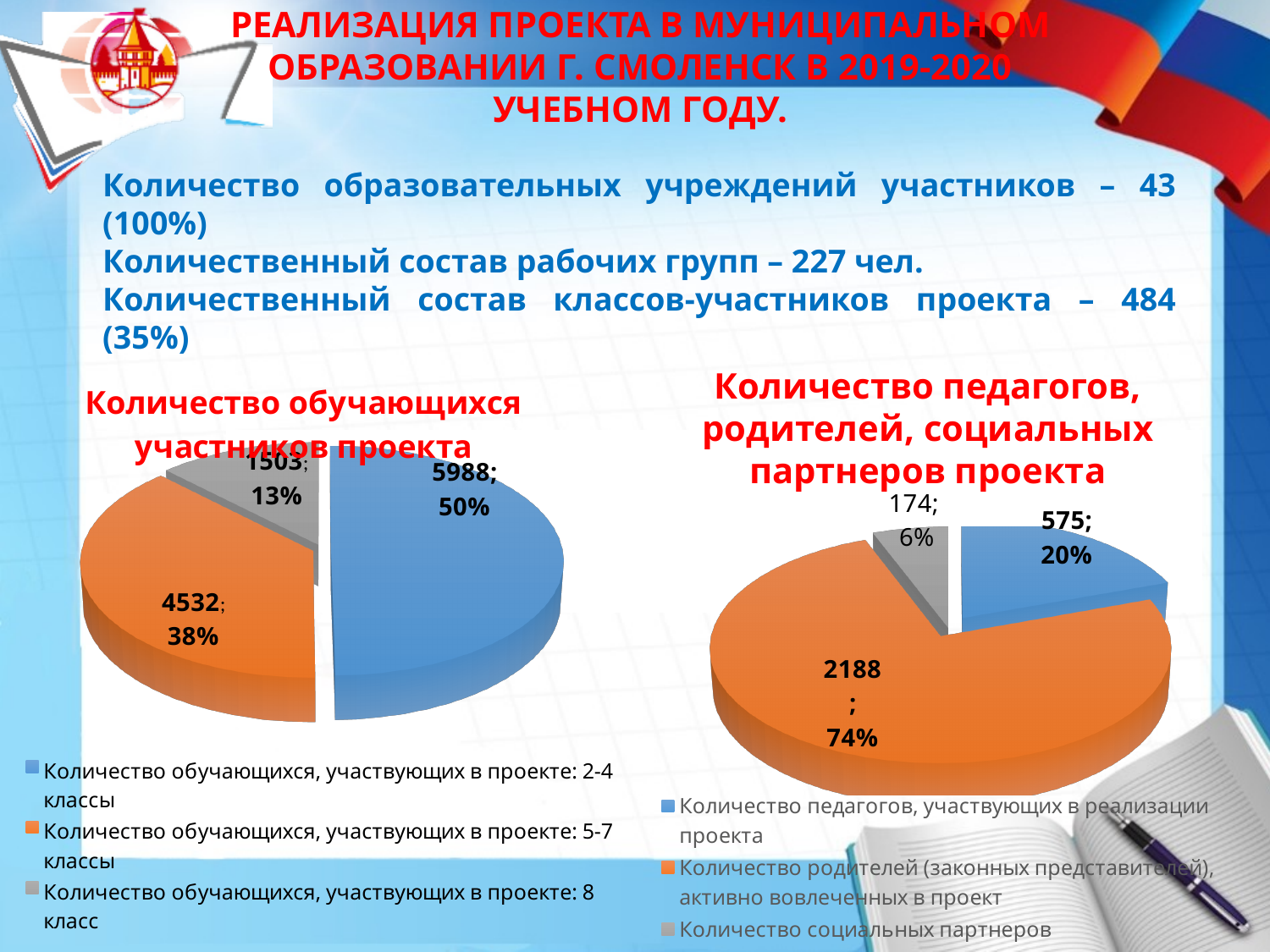
In the 'Количество обучающихся участников проекта' chart, what is the difference between the values for 2-4 классы and 5-7 классы? 1456 In the 'Количество педагогов, родителей, социальных партнеров проекта' chart, which is larger: the value for педагогов or the value for социальных партнеров? педагогов In the 'Количество обучающихся участников проекта' chart, what share of the pie is 'Количество обучающихся, участвующих в проекте: 8 класс'? 13% What type of chart is the 'Количество обучающихся участников проекта' chart? pie chart In the 'Количество педагогов, родителей, социальных партнеров проекта' chart, what share of the pie is 'Количество педагогов, участвующих в реализации проекта'? 20% In the 'Количество обучающихся участников проекта' chart, which category has the smallest slice? Количество обучающихся, участвующих в проекте: 8 класс In the 'Количество педагогов, родителей, социальных партнеров проекта' chart, which category has the largest slice? Количество родителей (законных представителей), активно вовлеченных в проект In the 'Количество обучающихся участников проекта' chart, what is the value for 'Количество обучающихся, участвующих в проекте: 5-7 классы'? 4532 In the 'Количество педагогов, родителей, социальных партнеров проекта' chart, what is the value for 'Количество родителей (законных представителей), активно вовлеченных в проект'? 2188 In the 'Количество обучающихся участников проекта' chart, what is the value for 'Количество обучающихся, участвующих в проекте: 2-4 классы'? 5988 How many slices does the 'Количество обучающихся участников проекта' chart have? 3 In the 'Количество педагогов, родителей, социальных партнеров проекта' chart, what is the value for 'Количество социальных партнеров'? 174